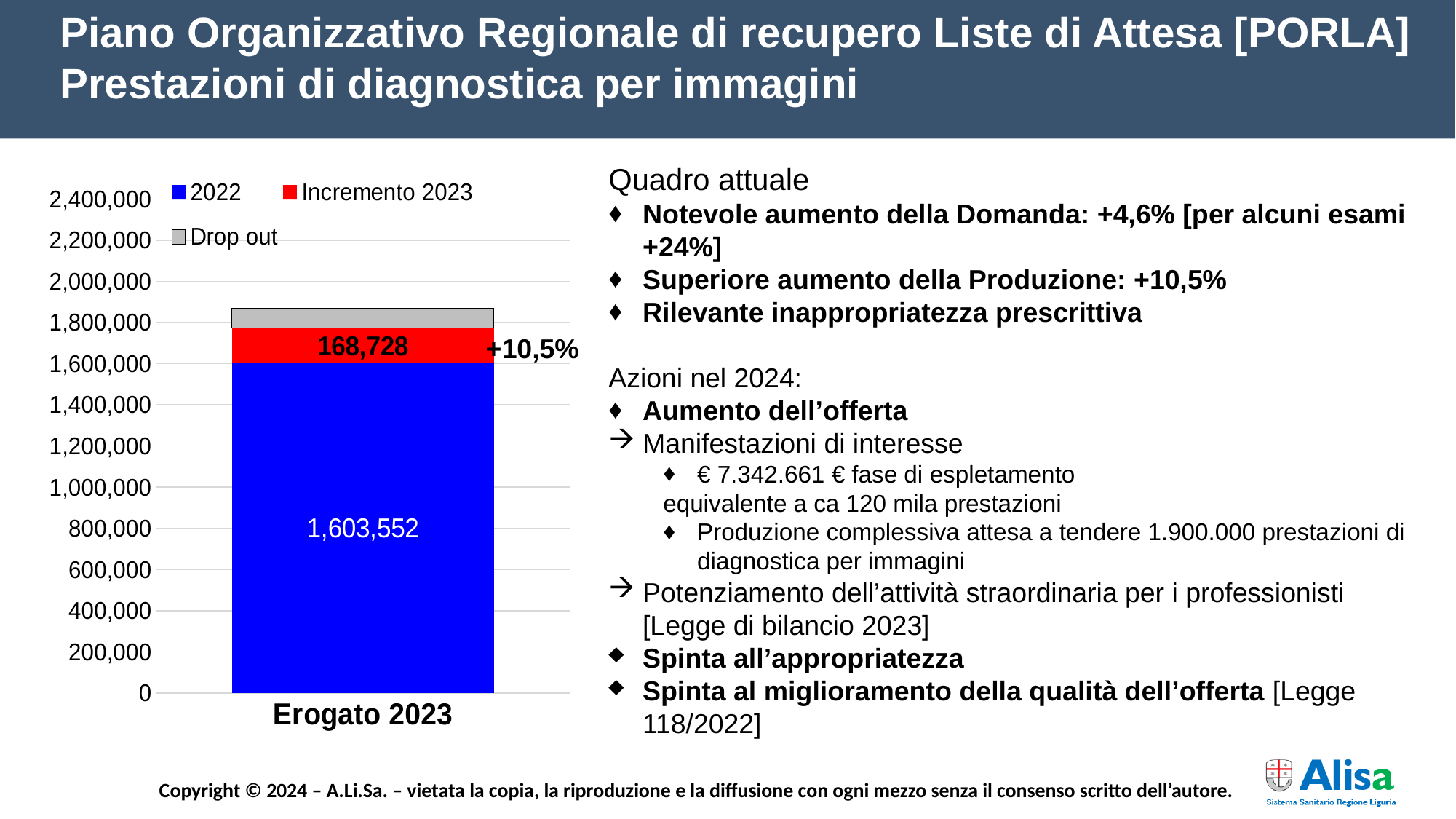
What kind of chart is shown on the slide? stacked bar chart What is the value of the Incremento 2023 series in the stacked bar? 168,728 Which series has the largest segment in the stacked bar? 2022 Which series has the smallest segment in the stacked bar? Drop out How many categories are shown on the x axis of the chart? 1 What is the value of the 2022 series in the stacked bar? 1,603,552 What percentage annotation is printed next to the red segment of the bar? +10,5% How many series does the chart legend list? 3 Is the total height of the stacked bar greater or less than 2,000,000? less What is the difference between the 2022 value and the Incremento 2023 value? 1,434,824 Which is larger, the 2022 value or the Incremento 2023 value? 2022 What is the category label shown under the bar? Erogato 2023